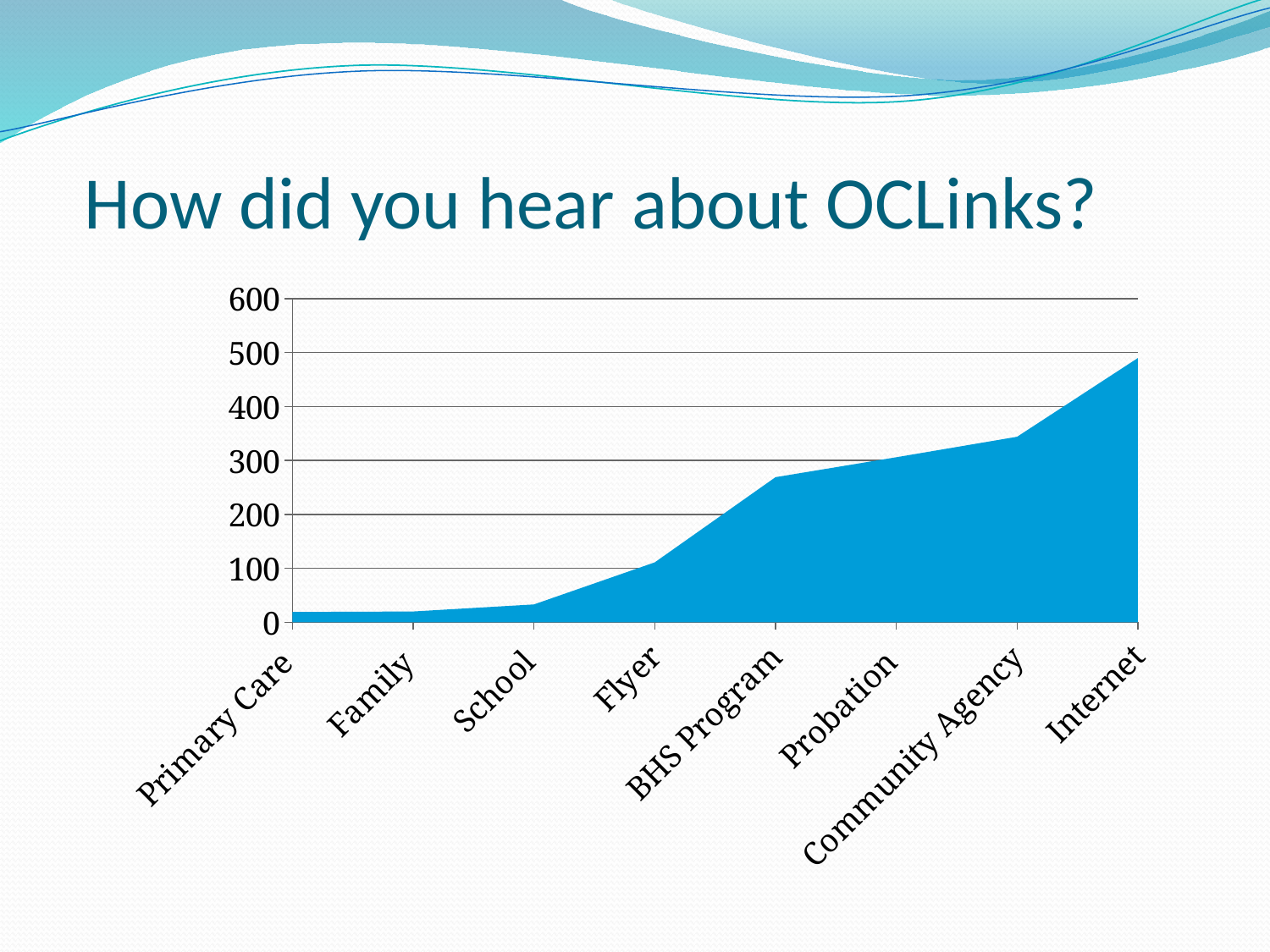
What is the title of the slide containing the chart? How did you hear about OCLinks? Is the value for School greater or less than 100? less How many categories are shown along the x axis? 8 Is the value for Flyer greater or less than 200? less Is the value for Internet greater or less than 400? greater What kind of chart is shown on the slide? area chart Which is larger, the value for Flyer or the value for School? Flyer Which category has the highest value? Internet Which is larger, the value for Internet or the value for BHS Program? Internet Do the values rise or fall moving from Primary Care to Internet along the x axis? rise